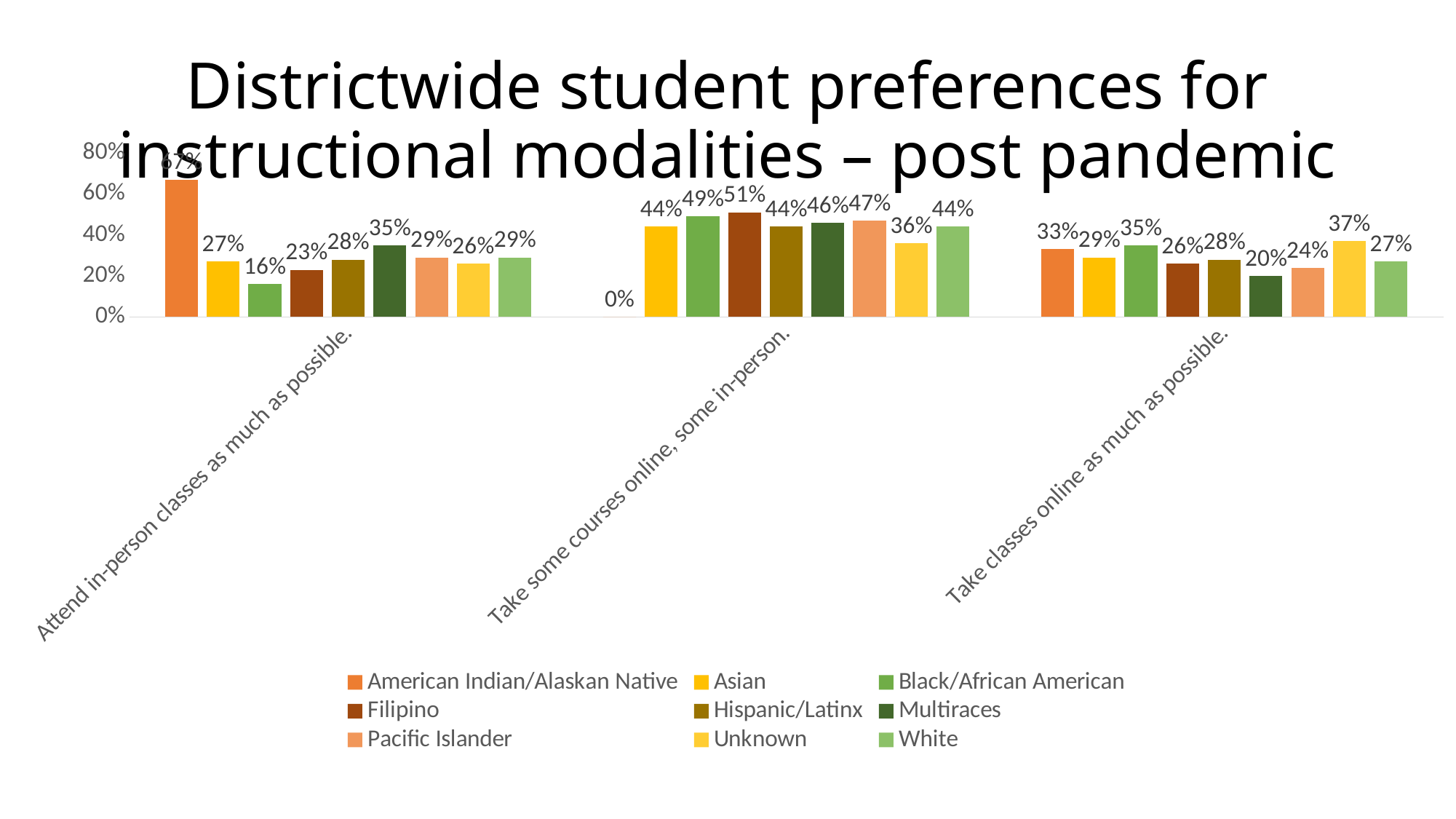
For Black/African American students, what is the difference between the value for 'Take some courses online, some in-person.' and the value for 'Attend in-person classes as much as possible.'? 33 percentage points How many instructional modality categories are shown on the x axis? 3 What percentage of Asian students prefer to attend in-person classes as much as possible? 27% What is the value for the Unknown group for 'Take classes online as much as possible.'? 37% Which group has the highest value for 'Take some courses online, some in-person.'? Filipino Which group has the lowest value for 'Attend in-person classes as much as possible.'? Black/African American What is the value for American Indian/Alaskan Native students for 'Take some courses online, some in-person.'? 0% What is the value for Filipino students for 'Take some courses online, some in-person.'? 51% For Multiraces students, which is larger: the value for 'Attend in-person classes as much as possible.' or the value for 'Take classes online as much as possible.'? Attend in-person classes as much as possible. Which group has the lowest value for 'Take classes online as much as possible.'? Multiraces How many series does the legend list? 9 What kind of chart is shown on the slide? bar chart